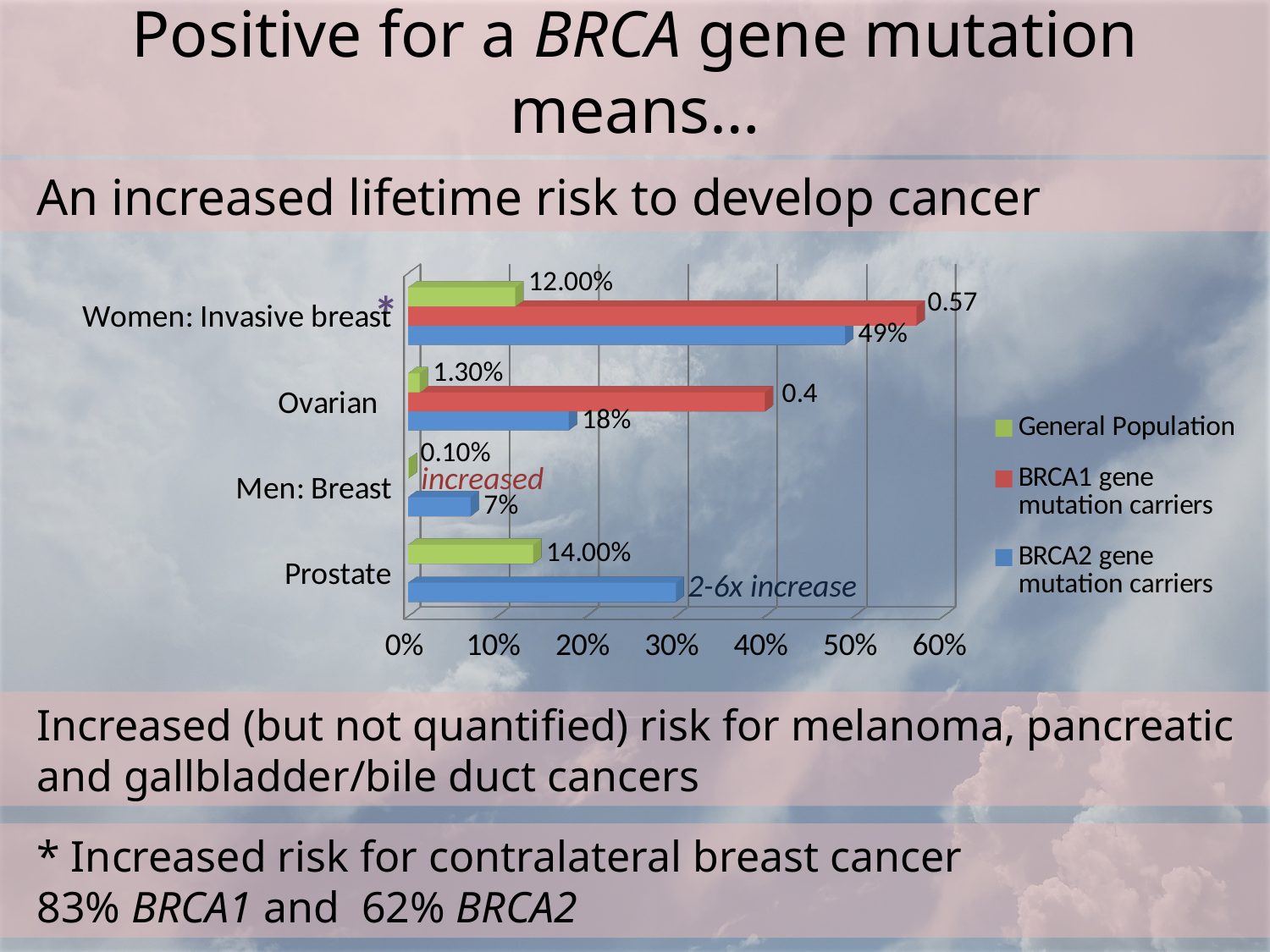
What is the BRCA2 gene mutation carriers value for Ovarian? 18% What is the BRCA2 gene mutation carriers value for Men: Breast? 7% Is the BRCA2 gene mutation carriers value for Prostate greater or less than 20%? greater What is the General Population value for Women: Invasive breast? 12.00% Which category has the lowest General Population value? Men: Breast How many series does the legend list? 3 What is the difference between the BRCA2 gene mutation carriers values for Women: Invasive breast and Ovarian? 31% What is the General Population value for Men: Breast? 0.10% Which category has the highest General Population value? Prostate How many categories are shown on the chart? 4 For Ovarian, which is larger: the BRCA1 gene mutation carriers value or the BRCA2 gene mutation carriers value? BRCA1 gene mutation carriers What is the BRCA1 gene mutation carriers value for Women: Invasive breast? 0.57